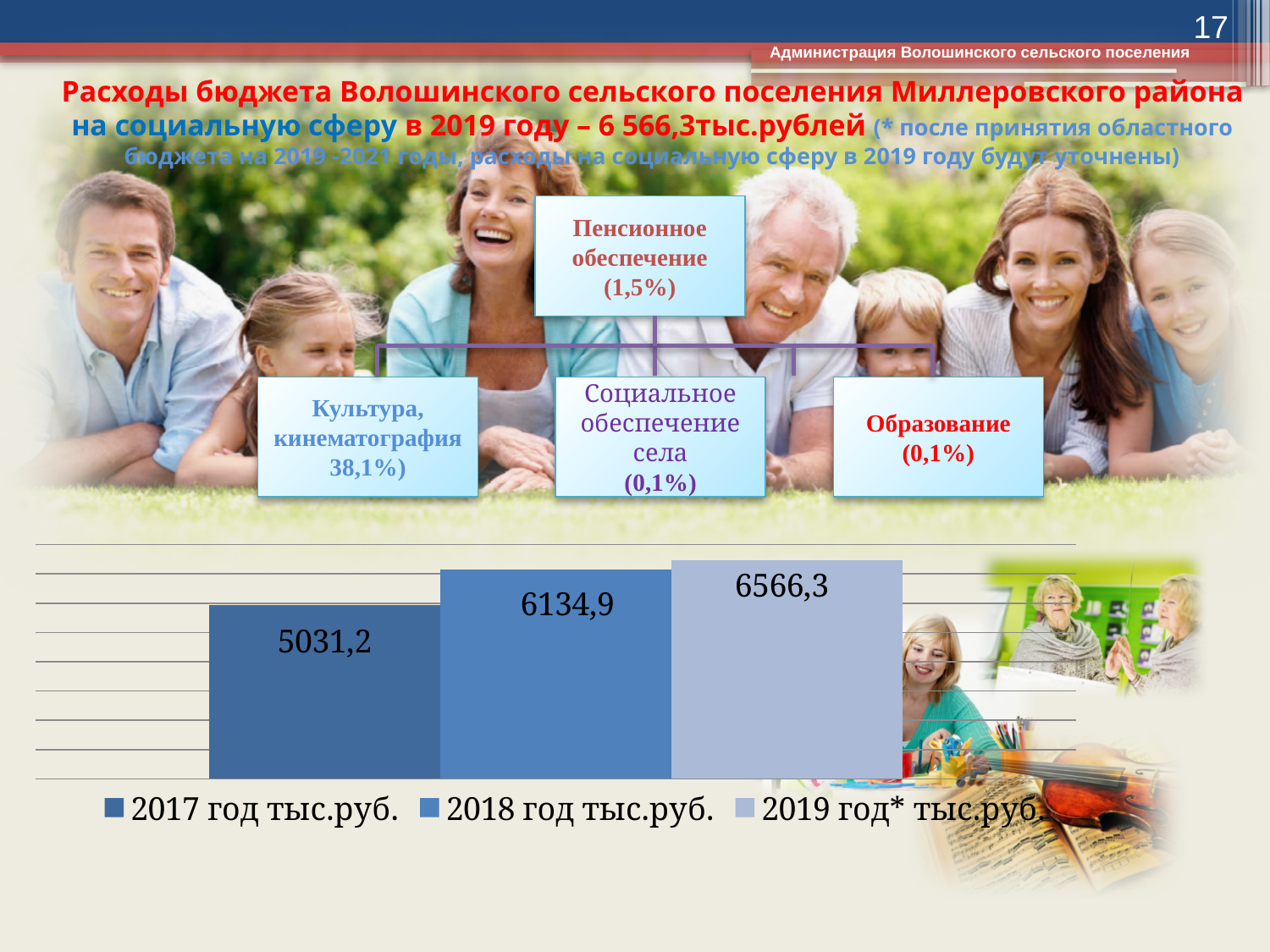
What kind of chart is shown at the bottom of the slide? bar chart Which is larger in the bar chart, the value for 2017 or the value for 2019? 2019 Which year has the highest value in the bar chart? 2019 год* тыс.руб. Which year has the lowest value in the bar chart? 2017 год тыс.руб. What is the difference between the 2019 and 2018 values in the bar chart? 431,4 What is the value for 2017 год тыс.руб. in the bar chart? 5031,2 What is the difference between the 2018 and 2017 values in the bar chart? 1103,7 How many series does the legend of the bar chart list? 3 Do the values in the bar chart rise or fall from 2017 to 2019? rise How many bars are plotted in the bar chart? 3 What is the value for 2019 год* тыс.руб. in the bar chart? 6566,3 What is the value for 2018 год тыс.руб. in the bar chart? 6134,9